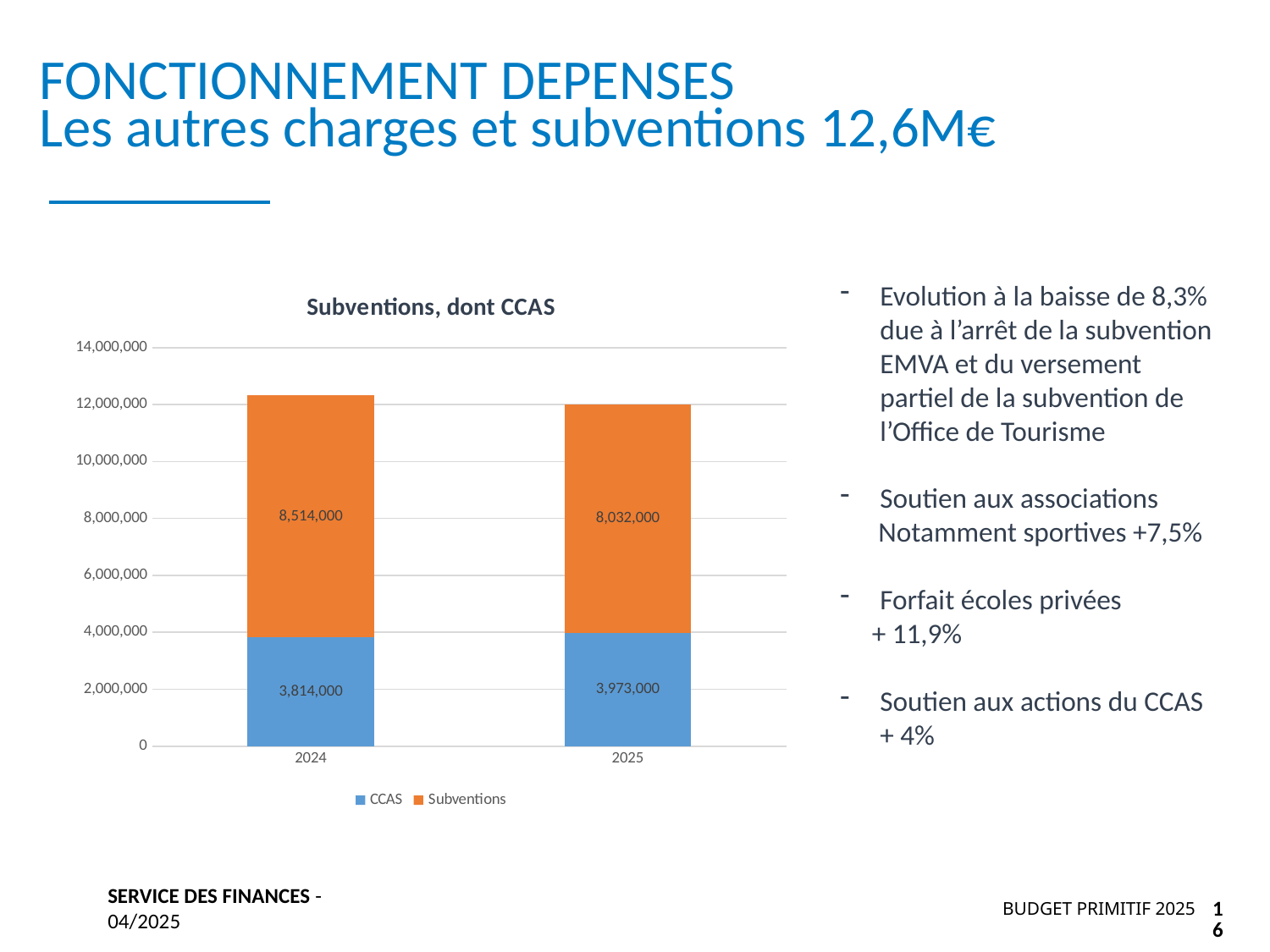
What is the value of Subventions for 2024? 8,514,000 How many series does the chart legend list? 2 What kind of chart is shown on the slide? Stacked bar chart What is the difference between the Subventions values for 2024 and 2025? 482,000 What is the value of Subventions for 2025? 8,032,000 What is the total of the stacked bar for 2025? 12,005,000 What is the title of the chart? Subventions, dont CCAS What is the value of CCAS for 2024? 3,814,000 Does the Subventions value rise or fall from 2024 to 2025? Fall What is the total of the stacked bar for 2024? 12,328,000 How many categories (years) are shown on the x axis of the chart? 2 Which year has the larger CCAS value, 2024 or 2025? 2025